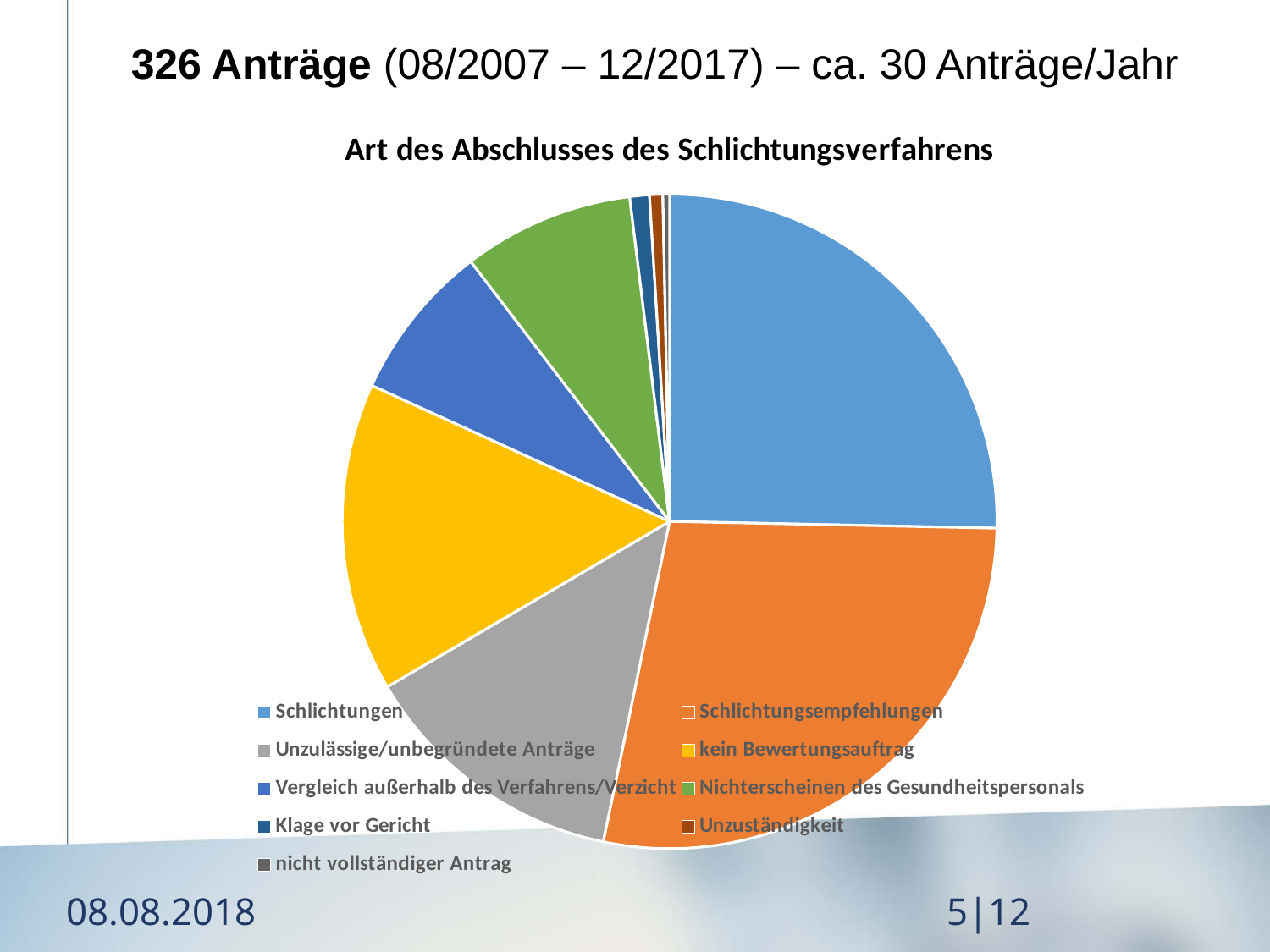
Which slice is larger, Schlichtungen or kein Bewertungsauftrag? Schlichtungen Which category has the largest slice of the pie? Schlichtungsempfehlungen Which slice is larger, Nichterscheinen des Gesundheitspersonals or Klage vor Gericht? Nichterscheinen des Gesundheitspersonals Which slice is larger, Unzulässige/unbegründete Anträge or Vergleich außerhalb des Verfahrens/Verzicht? Unzulässige/unbegründete Anträge What is the title of the chart? Art des Abschlusses des Schlichtungsverfahrens How many categories does the legend of the pie chart list? 9 What kind of chart is shown on the slide? pie chart What colour is the slice for Schlichtungsempfehlungen? orange